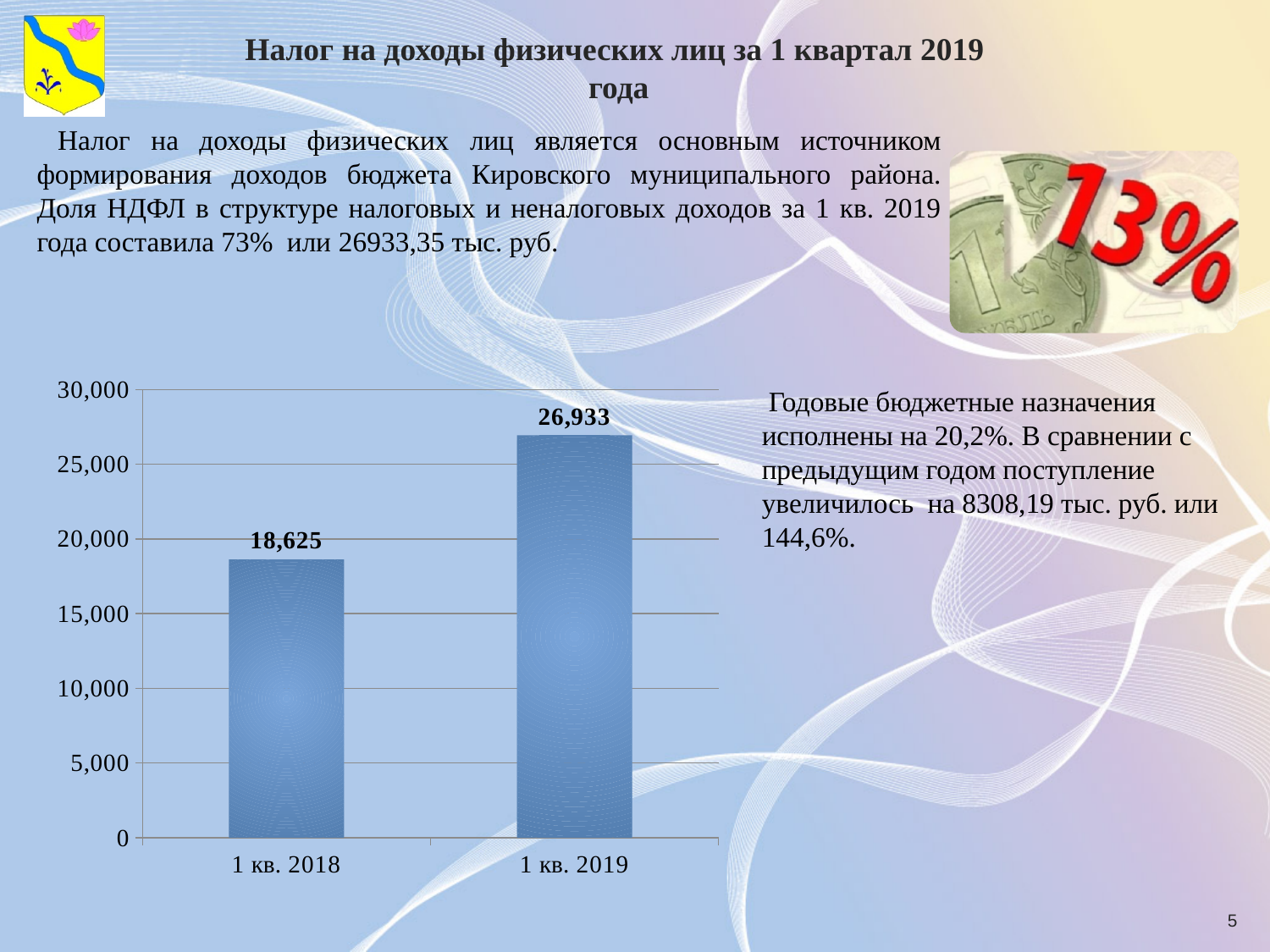
Which is larger, the value for 1 кв. 2018 or the value for 1 кв. 2019? 1 кв. 2019 What is the value for 1 кв. 2019? 26,933 What is the value for 1 кв. 2018? 18,625 Do the values rise or fall from 1 кв. 2018 to 1 кв. 2019? rise Is the value for 1 кв. 2019 greater or less than 25,000? greater Which category has the lowest value? 1 кв. 2018 Is the value for 1 кв. 2018 greater or less than 20,000? less How many categories are shown on the x axis of the chart? 2 What is the difference between the values for 1 кв. 2019 and 1 кв. 2018? 8,308 What is the highest tick value shown on the vertical axis of the chart? 30,000 Which category has the highest value? 1 кв. 2019 What kind of chart is shown on the slide? bar chart